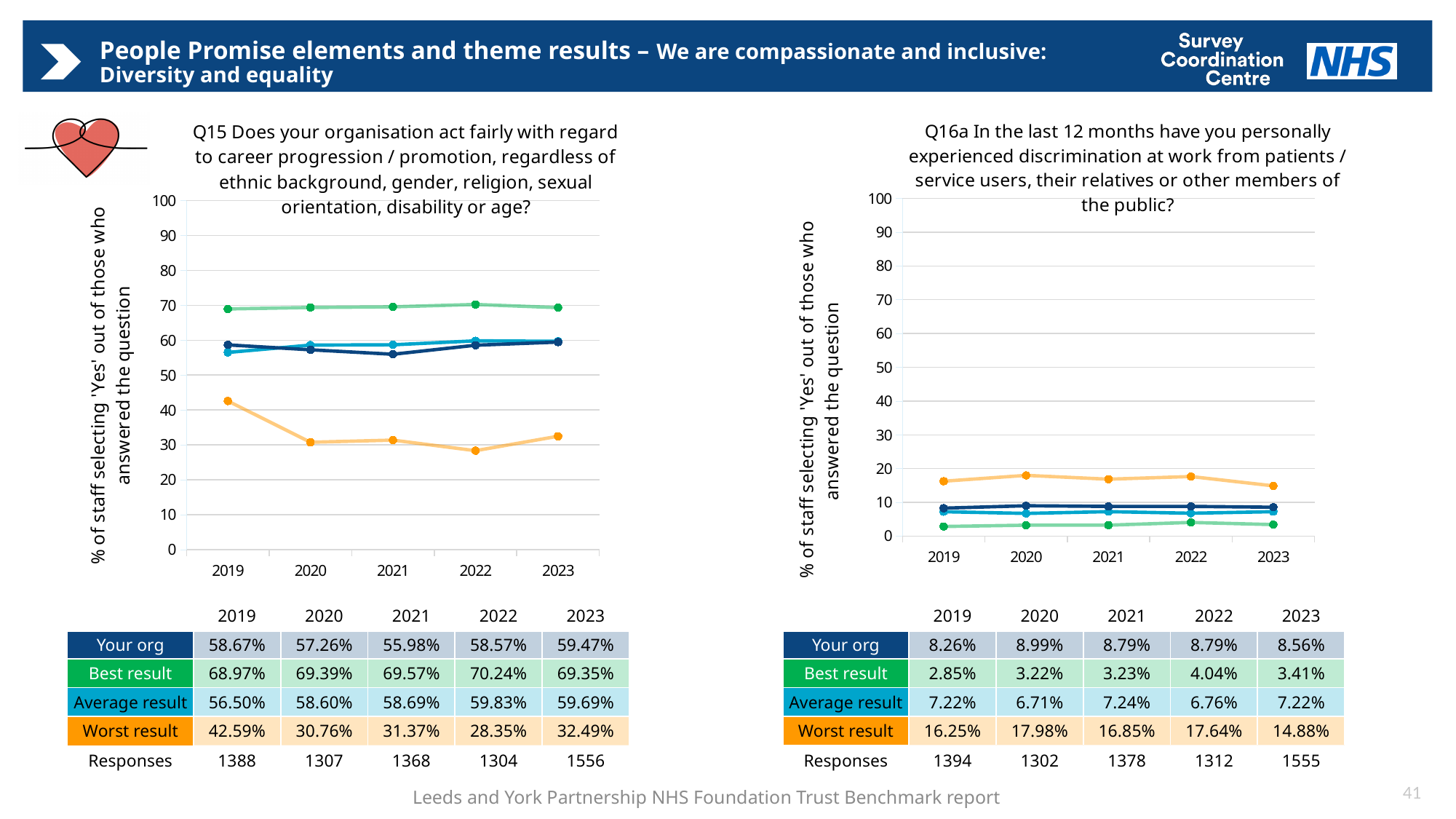
On the Q16a chart, what was the 'Average result' value in 2021? 7.24% What type of chart is the Q15 chart? Line chart On the Q15 chart, what was the 'Worst result' value in 2019? 42.59% On the Q16a chart, how many years are plotted on the x axis? 5 On the Q15 chart, in which year was the 'Your org' value lowest? 2021 On the Q15 chart, what is the difference between the 'Best result' and 'Your org' values in 2023? 9.88% On the Q15 chart, what was the 'Your org' value in 2023? 59.47% On the Q16a chart, how many responses were recorded in 2023? 1555 On the Q15 chart, is the 'Worst result' value for 2022 greater or less than 30? less On the Q16a chart, in which year was the 'Worst result' highest? 2020 On the Q16a chart, which is larger in 2022: the 'Your org' value or the 'Average result' value? Your org On the Q15 chart, in which year was the 'Best result' highest? 2022